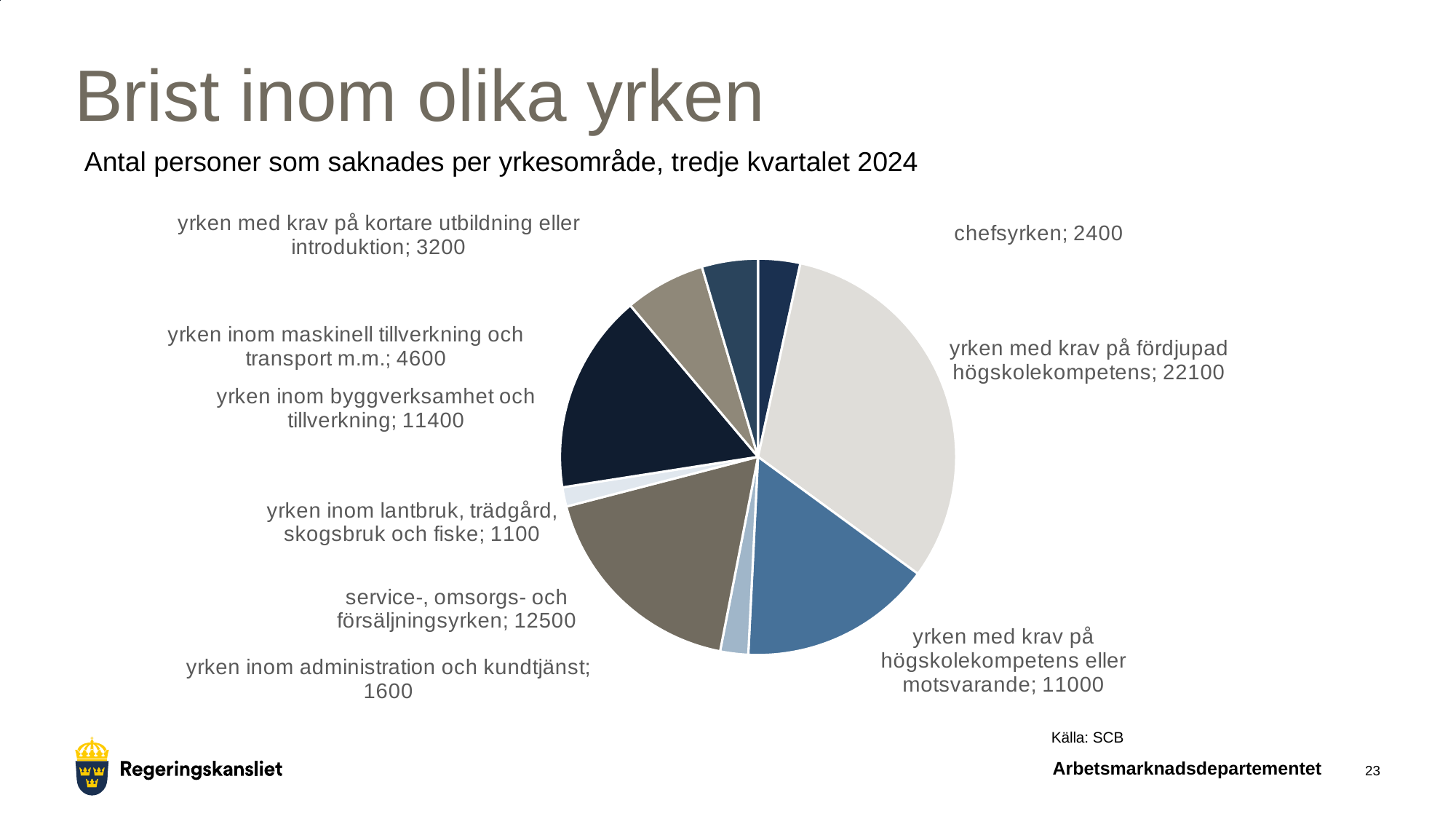
Which category has the largest value in the pie chart? yrken med krav på fördjupad högskolekompetens What is the value for 'yrken inom byggverksamhet och tillverkning'? 11400 What is the value for 'yrken inom administration och kundtjänst'? 1600 What is the value for 'chefsyrken'? 2400 Which is larger: 'yrken inom maskinell tillverkning och transport m.m.' or 'yrken med krav på kortare utbildning eller introduktion'? yrken inom maskinell tillverkning och transport m.m. What is the difference between 'service-, omsorgs- och försäljningsyrken' and 'yrken med krav på högskolekompetens eller motsvarande'? 1500 Which category has the smallest value in the pie chart? yrken inom lantbruk, trädgård, skogsbruk och fiske What is the subtitle of the chart on the slide? Antal personer som saknades per yrkesområde, tredje kvartalet 2024 What is the value for 'yrken med krav på fördjupad högskolekompetens'? 22100 What kind of chart is shown on the slide? pie chart How many slices does the pie chart have? 9 What is the total of all the values shown in the pie chart? 69900